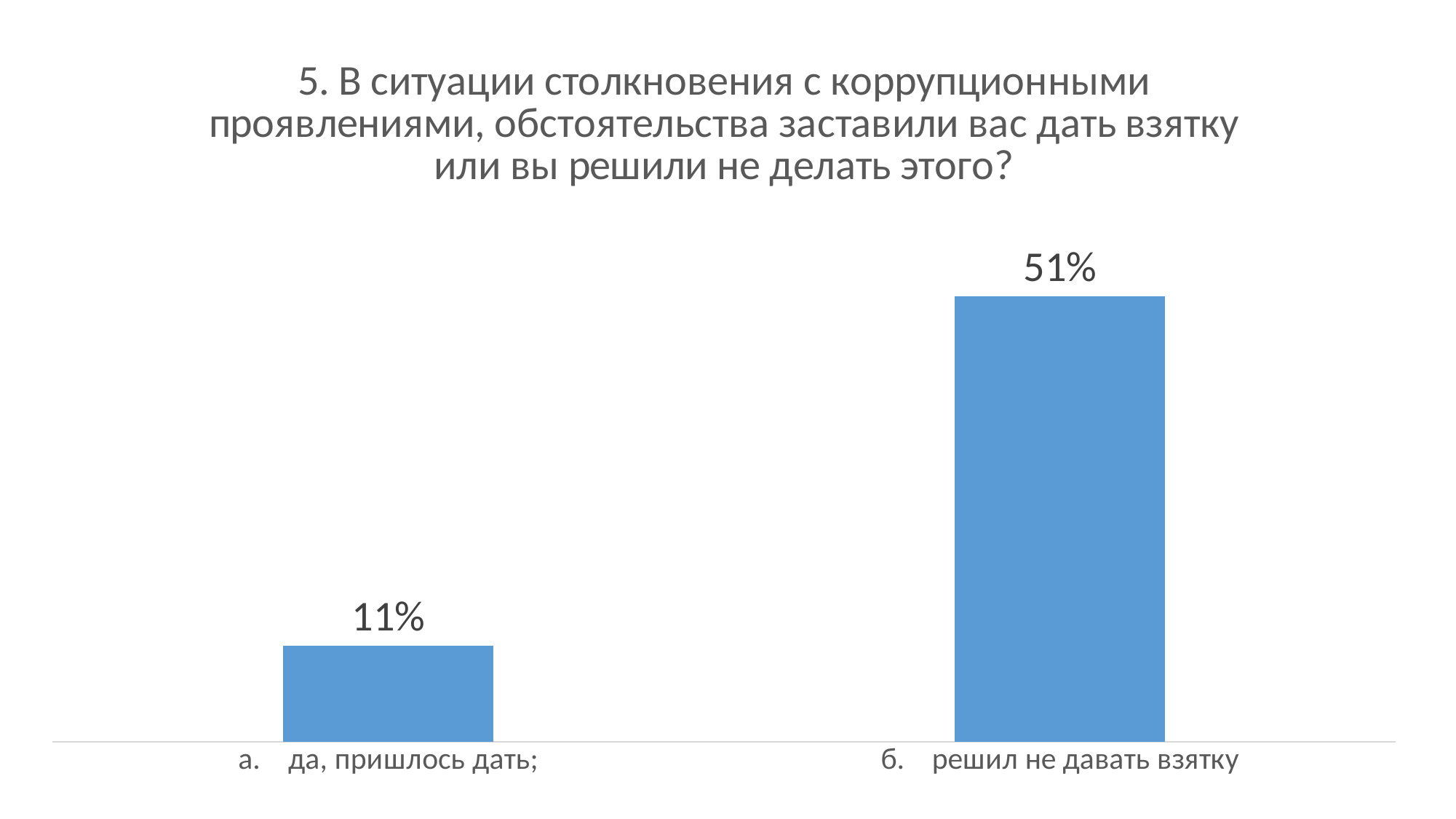
What is the total of the two values shown in the chart? 62% What is the value for "а. да, пришлось дать;"? 11% What colour are the bars in the chart? Blue Which is larger: the value for "а. да, пришлось дать;" or for "б. решил не давать взятку"? б. решил не давать взятку What is the value for "б. решил не давать взятку"? 51% Which category has the highest value? б. решил не давать взятку What is the difference between the values for "б. решил не давать взятку" and "а. да, пришлось дать;"? 40% What kind of chart is shown on the slide? Bar chart How many categories are shown in the chart? 2 Do the values rise or fall from left to right along the x axis? Rise What is the title of the chart? 5. В ситуации столкновения с коррупционными проявлениями, обстоятельства заставили вас дать взятку или вы решили не делать этого? Which category has the lowest value? а. да, пришлось дать;